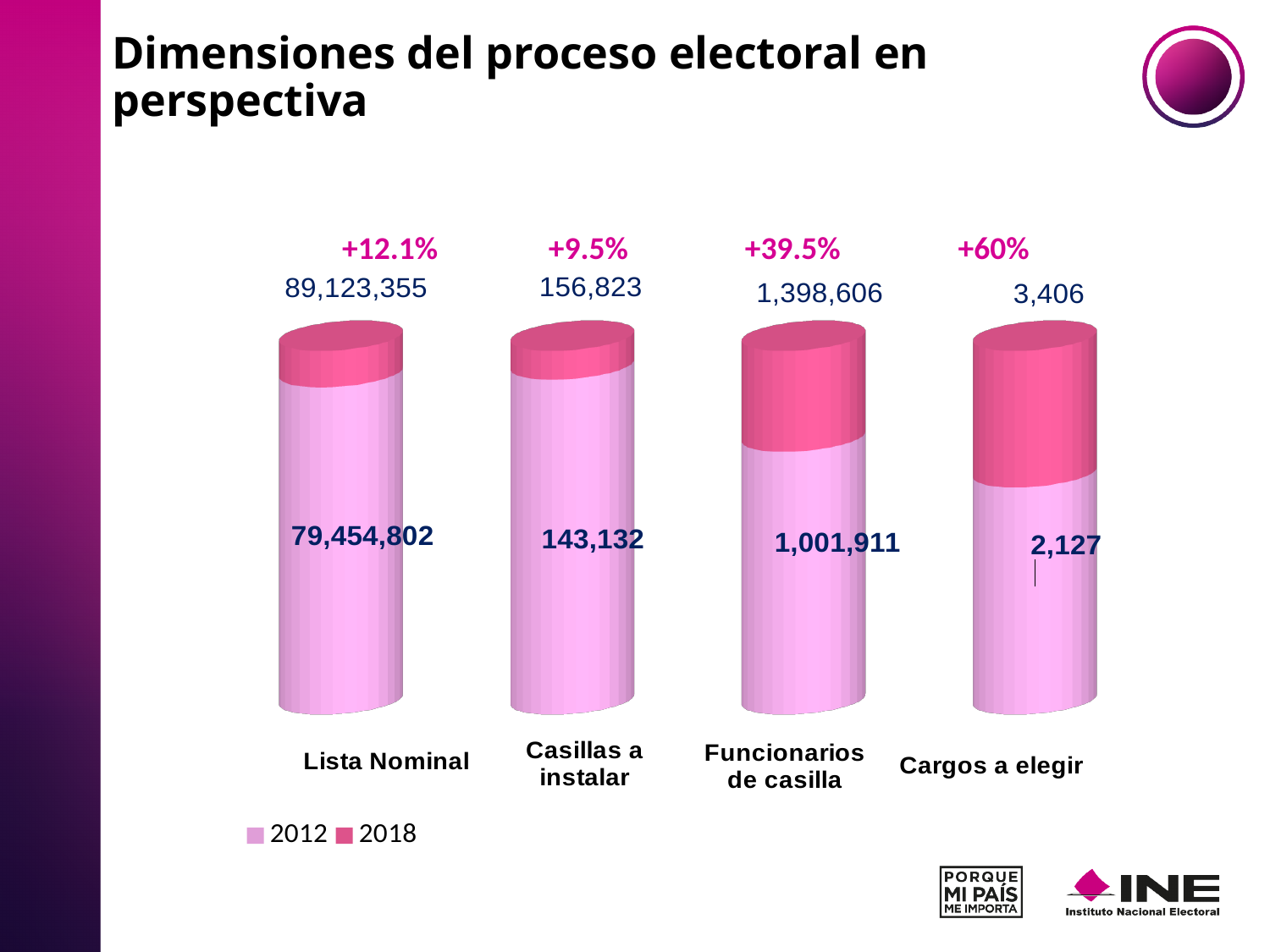
Which is larger for Casillas a instalar, the 2012 value or the 2018 value? 2018 Which category shows the smallest percentage increase from 2012 to 2018? Casillas a instalar What is the difference between the 2018 and 2012 values for Cargos a elegir? 1,279 What is the 2018 value for Lista Nominal? 89,123,355 What is the 2018 value for Cargos a elegir? 3,406 What is the 2012 value for Lista Nominal? 79,454,802 What is the 2012 value for Funcionarios de casilla? 1,001,911 How many categories are shown on the x axis? 4 Which category shows the largest percentage increase from 2012 to 2018? Cargos a elegir What is the 2018 value for Casillas a instalar? 156,823 How many series does the legend list? 2 What percentage increase is shown above the Funcionarios de casilla bar? +39.5%